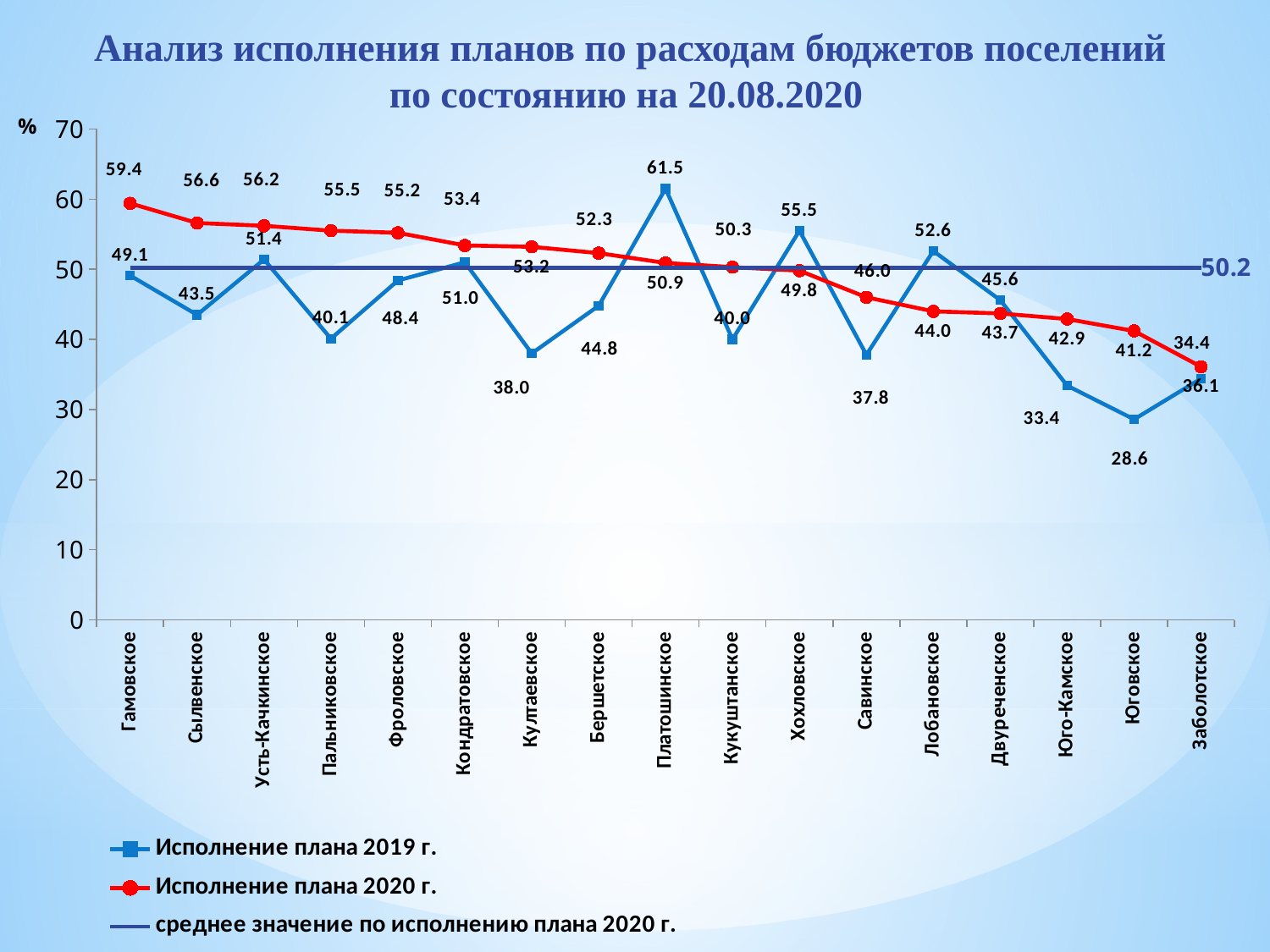
What is the difference between the 2020 and 2019 values for Гамовское? 10.3 What is the value of Исполнение плана 2019 г. for Платошинское? 61.5 How many settlements are shown on the x axis? 17 What is the value of Исполнение плана 2020 г. for Гамовское? 59.4 For Хохловское, which is larger: the 2019 value or the 2020 value? 2019 (55.5) Which settlement has the highest value for Исполнение плана 2020 г.? Гамовское Which settlement has the lowest value for Исполнение плана 2019 г.? Юговское Which settlement has the highest value for Исполнение плана 2019 г.? Платошинское How many series does the legend list? 3 What kind of chart is shown on the slide? Line chart What is the value of the line 'среднее значение по исполнению плана 2020 г.'? 50.2 Does the Исполнение плана 2020 г. series rise or fall from left to right along the x axis? Fall